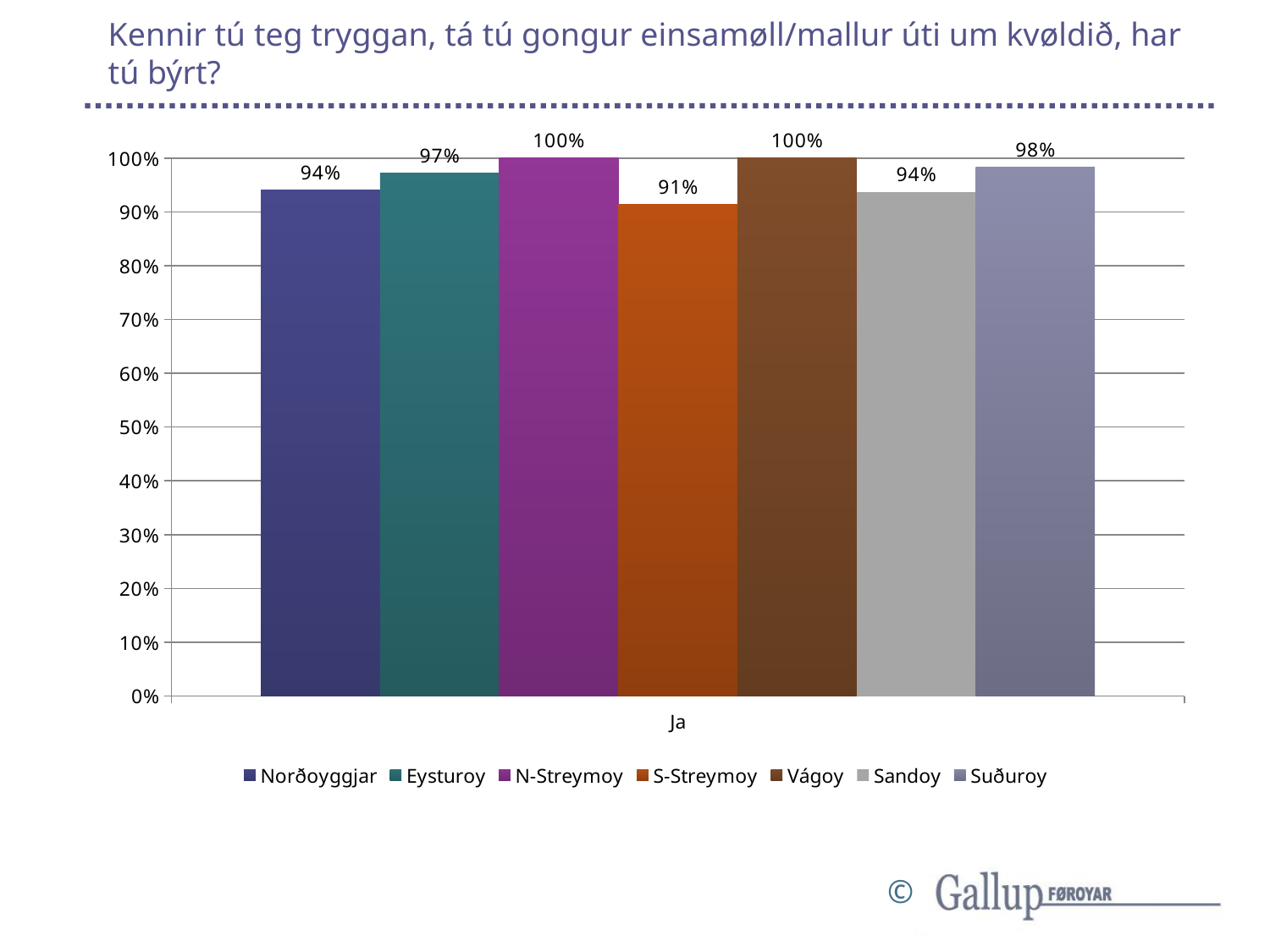
Which two regions share the highest value of 100%? N-Streymoy and Vágoy What is the difference between the values for Eysturoy and Norðoyggjar? 3% What is the difference between the values for Suðuroy and S-Streymoy? 7% What is the value for S-Streymoy? 91% Which is larger, the value for Vágoy or the value for Sandoy? Vágoy What kind of chart is shown on the slide? Bar chart What is the value for Suðuroy? 98% What is the value for Eysturoy? 97% How many series does the legend list? 7 What is the value for Norðoyggjar? 94% What is the label of the single category on the x axis? Ja Which region has the lowest value? S-Streymoy